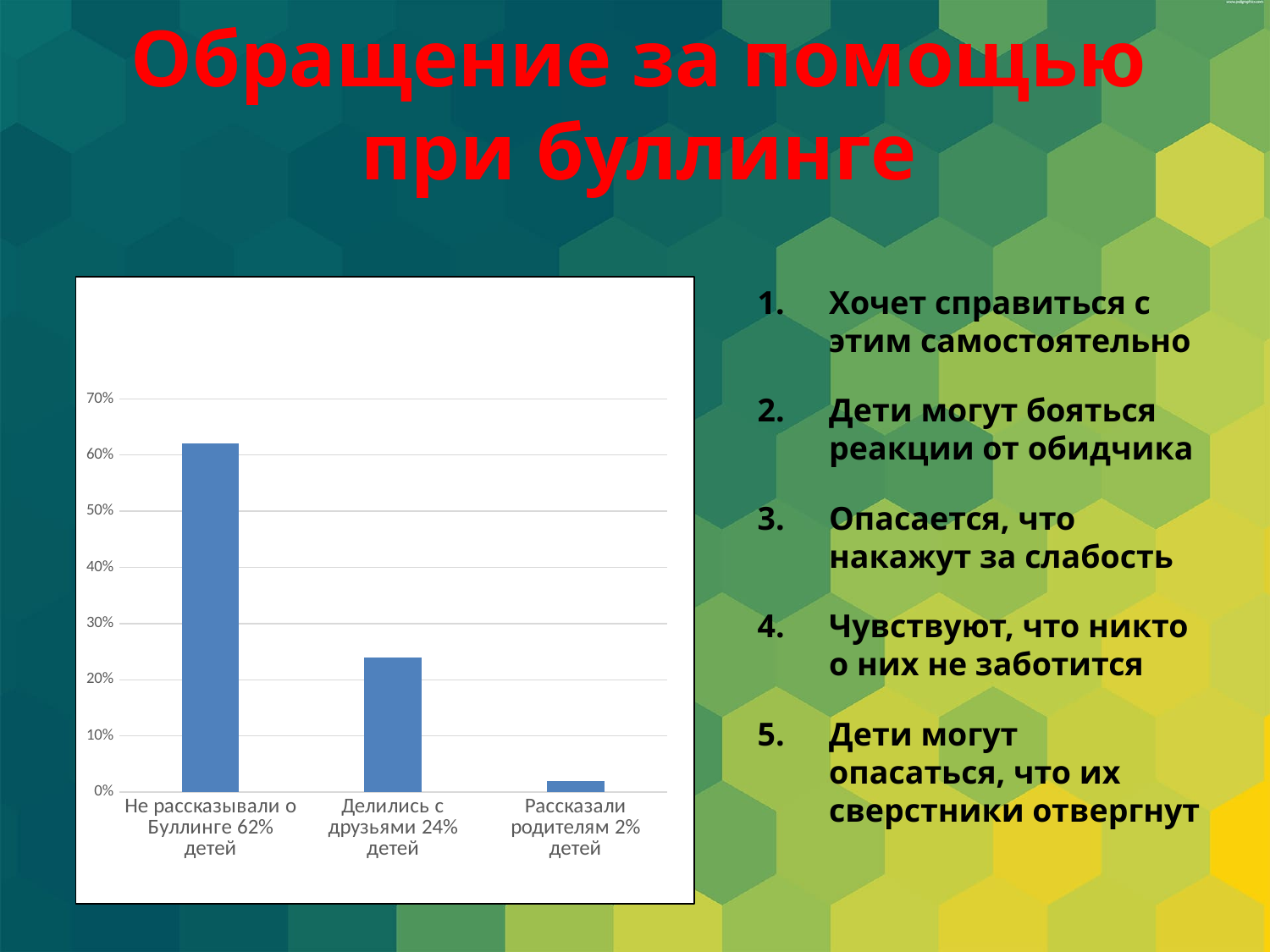
What percentage of children is given for the category "Рассказали родителям"? 2% Which category has the lowest bar? Рассказали родителям What percentage of children is given for the category "Не рассказывали о Буллинге"? 62% What kind of chart is shown on the slide? bar chart What is the difference between the percentage for "Делились с друзьями" and "Рассказали родителям"? 22% What percentage of children is given for the category "Делились с друзьями"? 24% Which category has the highest bar? Не рассказывали о Буллинге How many bars (categories) does the chart show? 3 What is the difference between the percentage for "Не рассказывали о Буллинге" and "Делились с друзьями"? 38% Which is larger: the value for "Делились с друзьями" or the value for "Рассказали родителям"? Делились с друзьями Is the value for "Не рассказывали о Буллинге" greater or less than 50%? greater Do the bar values rise or fall from left to right along the x axis? fall